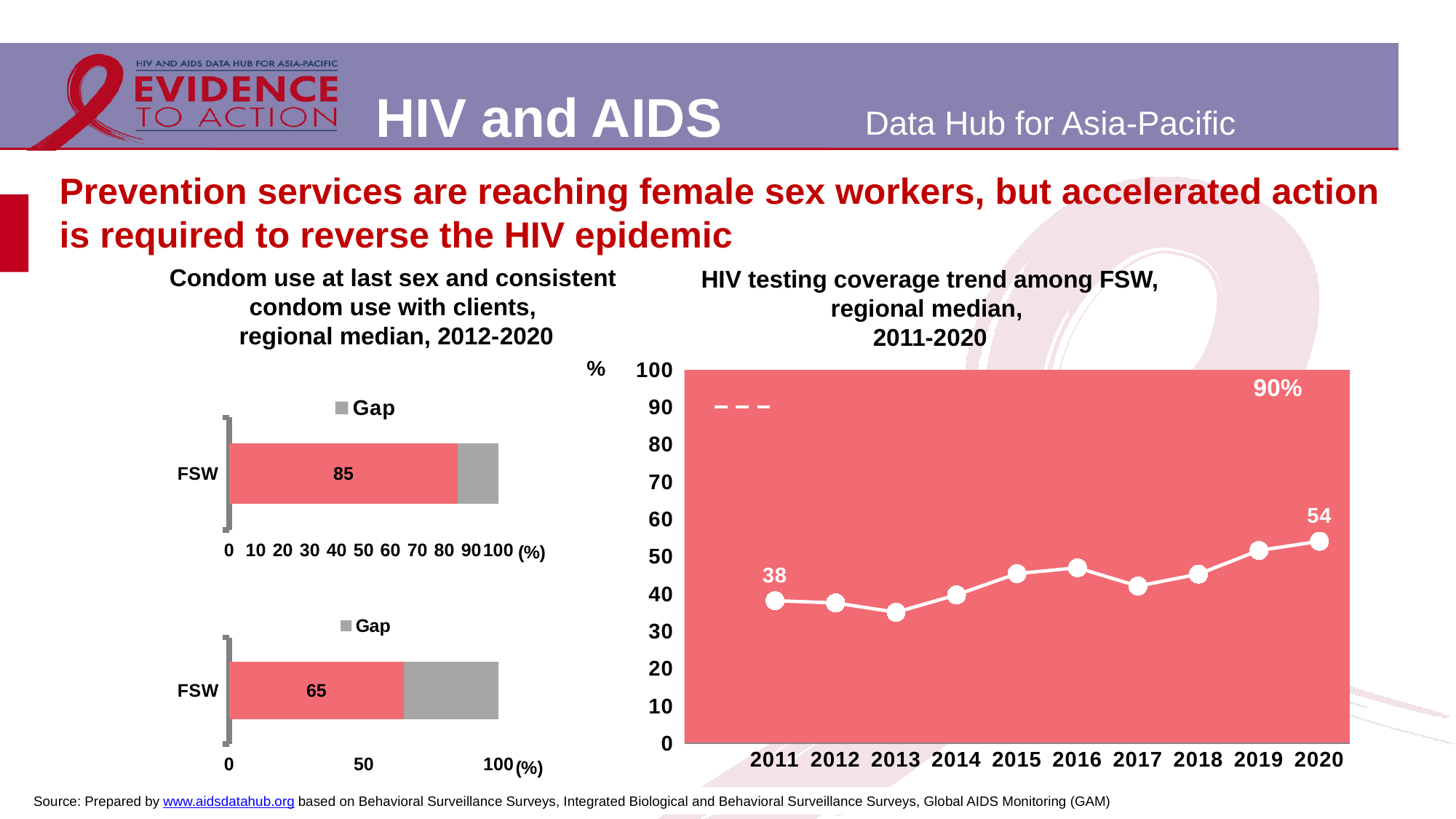
On the 'HIV testing coverage trend among FSW' chart, is the value for 2016 greater or less than 40? greater On the 'HIV testing coverage trend among FSW' chart, what is the value for 2020? 54 What kind of chart is the 'HIV testing coverage trend among FSW' chart? line chart On the bottom-left bar chart (consistent condom use with clients), what is the value for FSW? 65 On the 'HIV testing coverage trend among FSW' chart, which year has the higher value, 2011 or 2020? 2020 On the 'HIV testing coverage trend among FSW' chart, what is the difference between the 2020 value and the 2011 value? 16 What target percentage is marked by the dashed line on the 'HIV testing coverage trend among FSW' chart? 90% On the 'HIV testing coverage trend among FSW' chart, is the value for 2013 greater or less than 40? less On the 'HIV testing coverage trend among FSW' chart, what is the value for 2011? 38 On the 'HIV testing coverage trend among FSW' chart, do the values generally rise or fall from 2011 to 2020? rise On the top-left bar chart (condom use at last sex), what is the value for FSW? 85 How many years are plotted on the 'HIV testing coverage trend among FSW' chart? 10